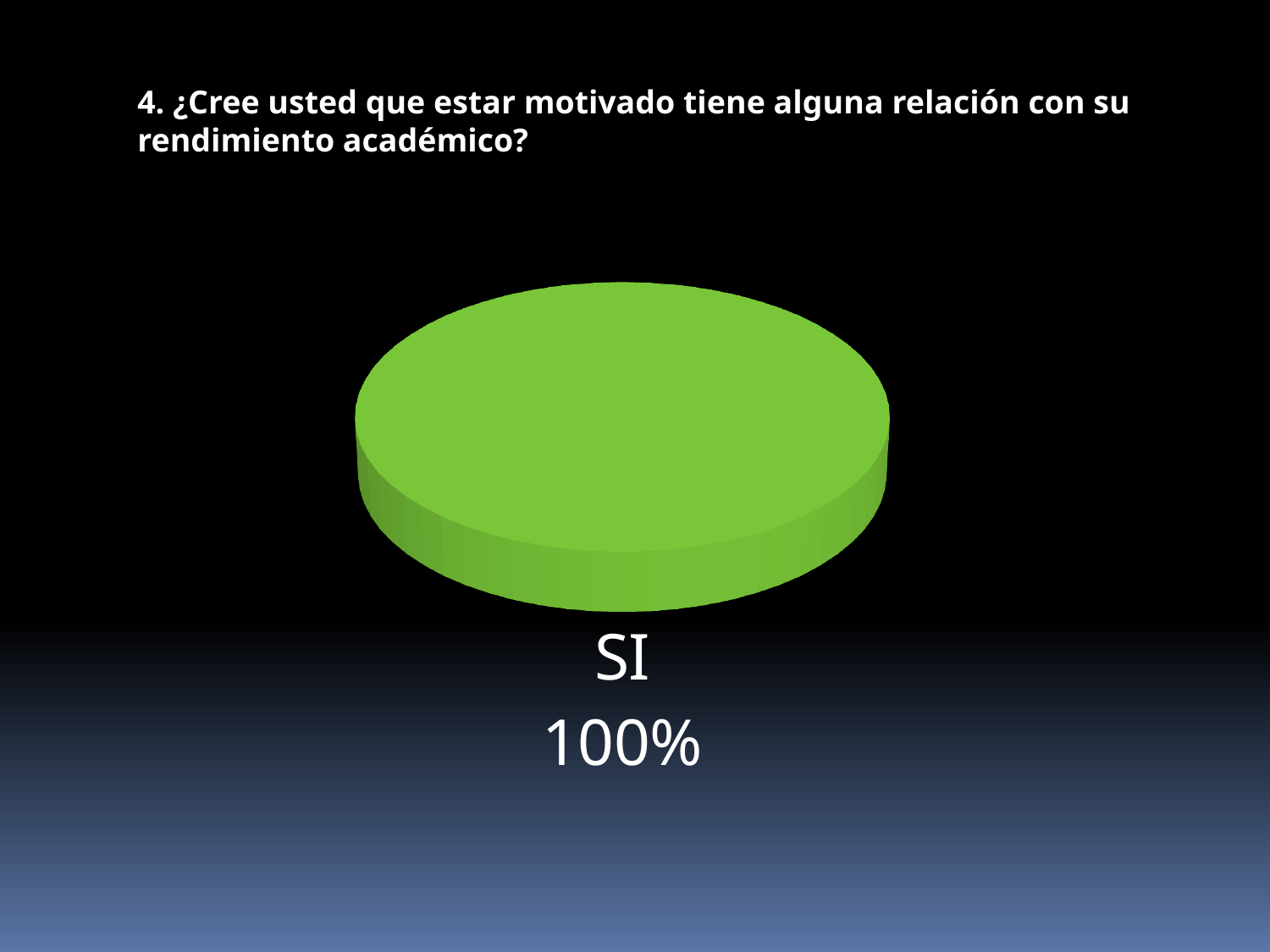
What share of the pie does the SI slice take up? 100% What is the label of the only slice in the pie chart? SI Which category has the largest share of the pie? SI What colour is the SI slice of the pie chart? green What kind of chart is shown on the slide? pie chart What percentage is shown for the SI slice? 100% Is the value for SI greater or less than 50%? greater How many slices does the pie chart have? 1